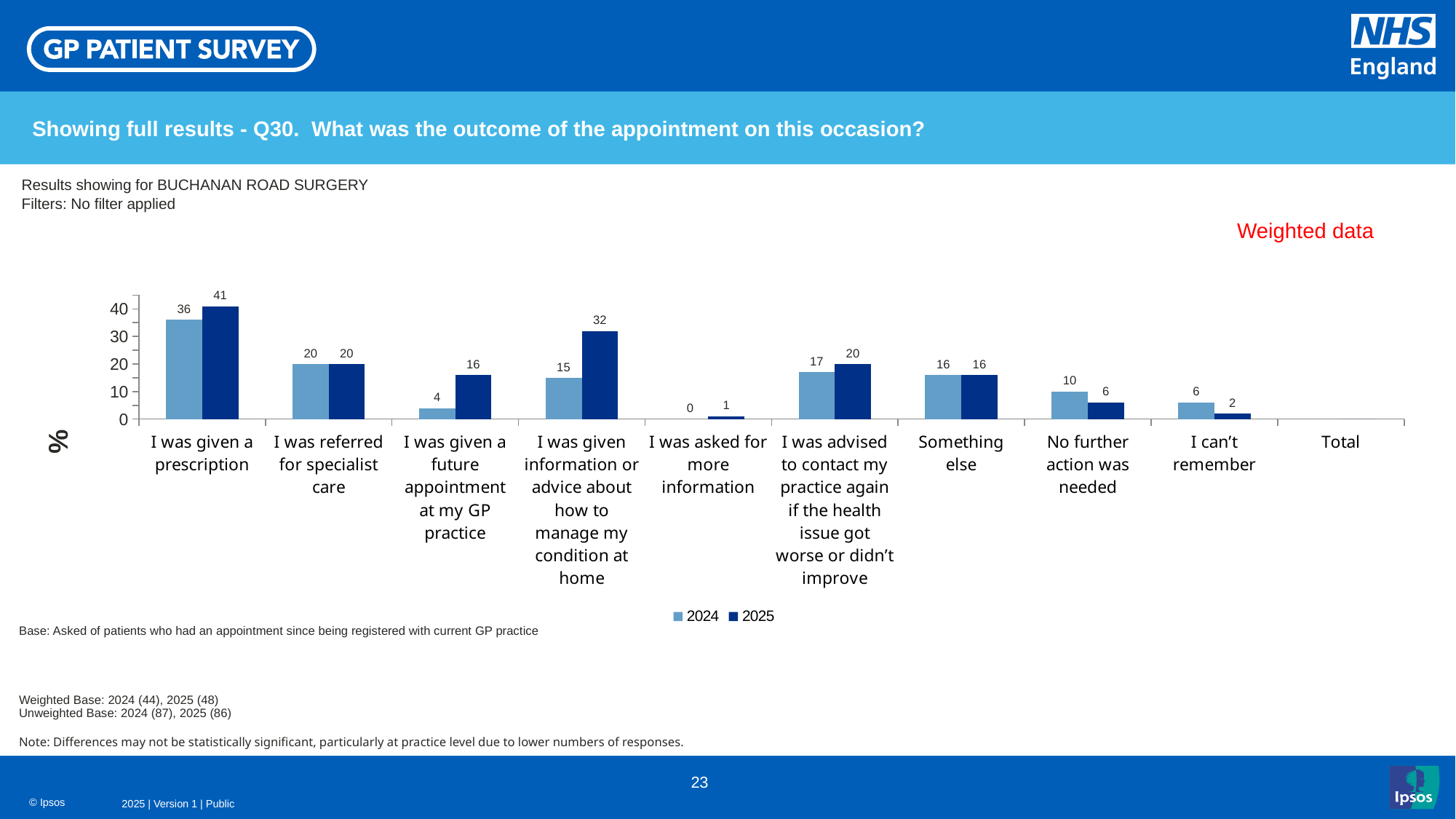
Which category has the lowest 2024 value? I was asked for more information What is the 2025 value for 'I was given a future appointment at my GP practice'? 16 What is the difference between the 2024 and 2025 values for 'I can't remember'? 4 What is the 2024 value for 'I was given information or advice about how to manage my condition at home'? 15 What kind of chart is shown on the slide? Bar chart What is the 2024 value for 'No further action was needed'? 10 What is the 2025 value for 'I was given a prescription'? 41 How many series does the legend list? 2 What is the difference between the 2025 and 2024 values for 'I was given information or advice about how to manage my condition at home'? 17 Which practice are the results shown for? BUCHANAN ROAD SURGERY Which category has the highest 2025 value? I was given a prescription Which is larger for 'No further action was needed': the 2024 value or the 2025 value? 2024